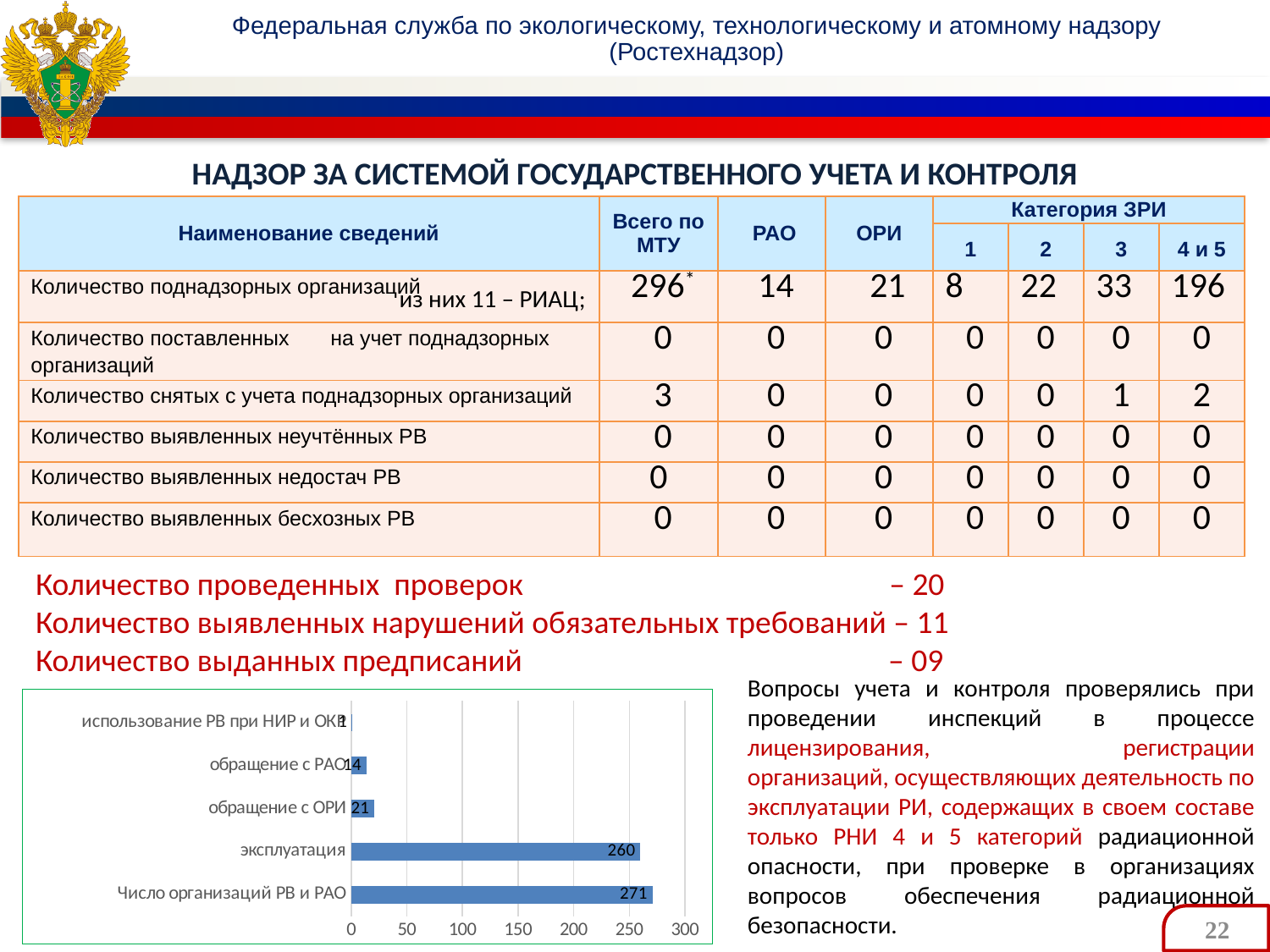
In the bar chart, which category has the lowest value? использование РВ при НИР и ОКР In the bar chart, is the value for "эксплуатация" greater or less than 250? greater In the bar chart, which is larger: the value for "обращение с ОРИ" or the value for "обращение с РАО"? обращение с ОРИ In the bar chart, what is the value for "Число организаций РВ и РАО"? 271 In the bar chart, is the value for "использование РВ при НИР и ОКР" greater or less than 50? less What kind of chart is shown at the bottom left of the slide? bar chart In the bar chart, what is the value for "обращение с РАО"? 14 In the bar chart, what is the value for "эксплуатация"? 260 In the bar chart, which category has the highest value? Число организаций РВ и РАО In the bar chart, what is the value for "обращение с ОРИ"? 21 How many categories are shown in the bar chart? 5 In the bar chart, what is the difference between the values for "Число организаций РВ и РАО" and "эксплуатация"? 11